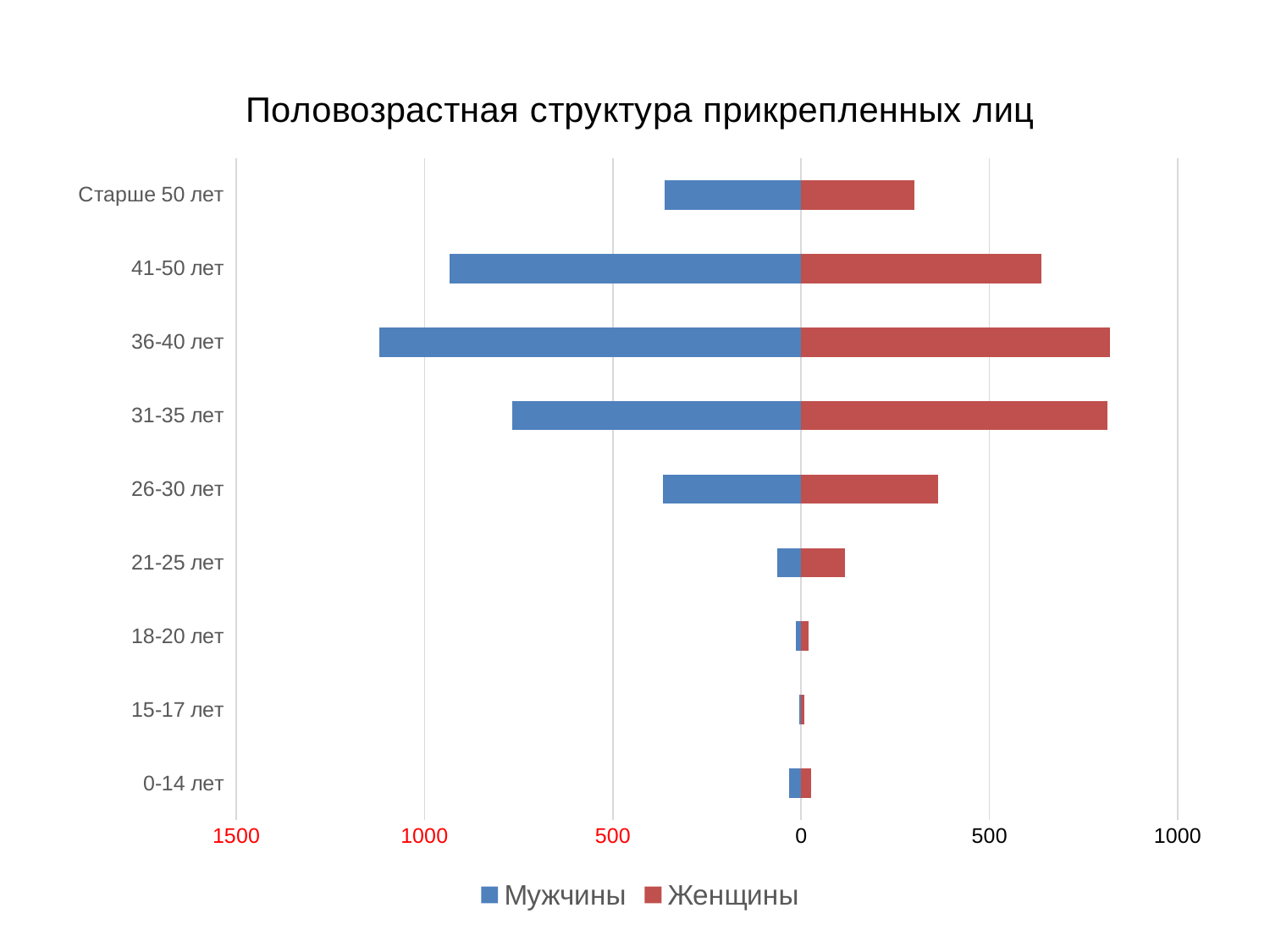
Is the value for Мужчины in the 36-40 лет category greater or less than 1000? greater How many series does the legend list? 2 Which age category has the lowest value for Женщины? 15-17 лет What kind of chart is shown on the slide? bar chart Is the value for Мужчины in the 31-35 лет category greater or less than 500? greater How many age categories are shown on the chart? 9 Which is larger: the value for Женщины in 41-50 лет or in 26-30 лет? 41-50 лет Is the value for Женщины in the 41-50 лет category greater or less than 500? greater Which age category has the highest value for Мужчины? 36-40 лет What is the title of the chart? Половозрастная структура прикрепленных лиц Which is larger: the value for Мужчины in 41-50 лет or in 31-35 лет? 41-50 лет